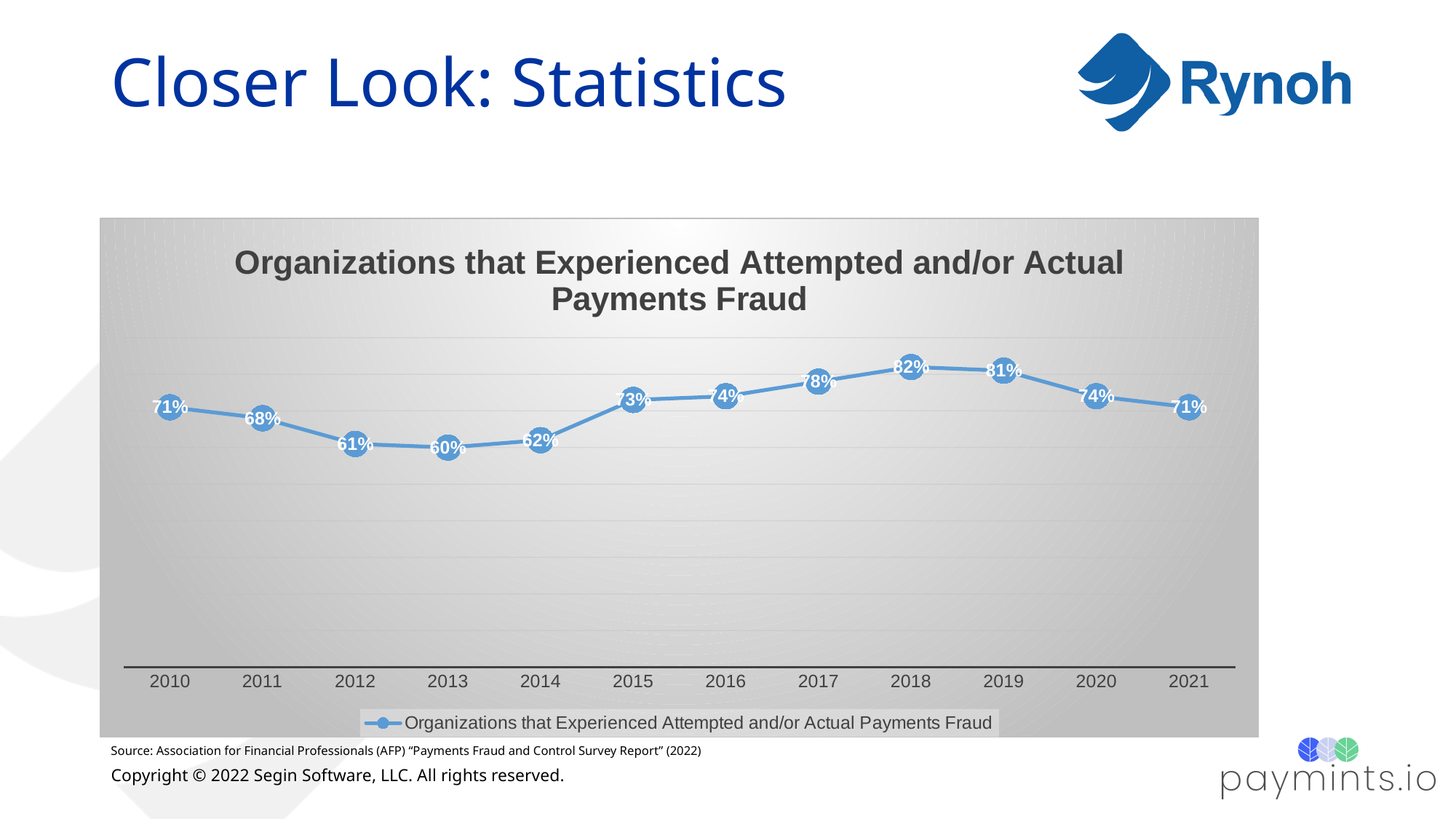
Which year has the highest value on the chart? 2018 Do the values rise or fall from 2014 to 2018? Rise What value is shown for 2013? 60% What percentage of organizations experienced attempted and/or actual payments fraud in 2018? 82% How many series does the legend list? 1 What is the difference between the values for 2018 and 2013? 22% What is the title of the chart? Organizations that Experienced Attempted and/or Actual Payments Fraud Which year has the lowest value on the chart? 2013 What kind of chart is shown on the slide? Line chart How many years are plotted on the x axis? 12 What value is shown for 2021? 71% Which year has a larger value, 2017 or 2020? 2017